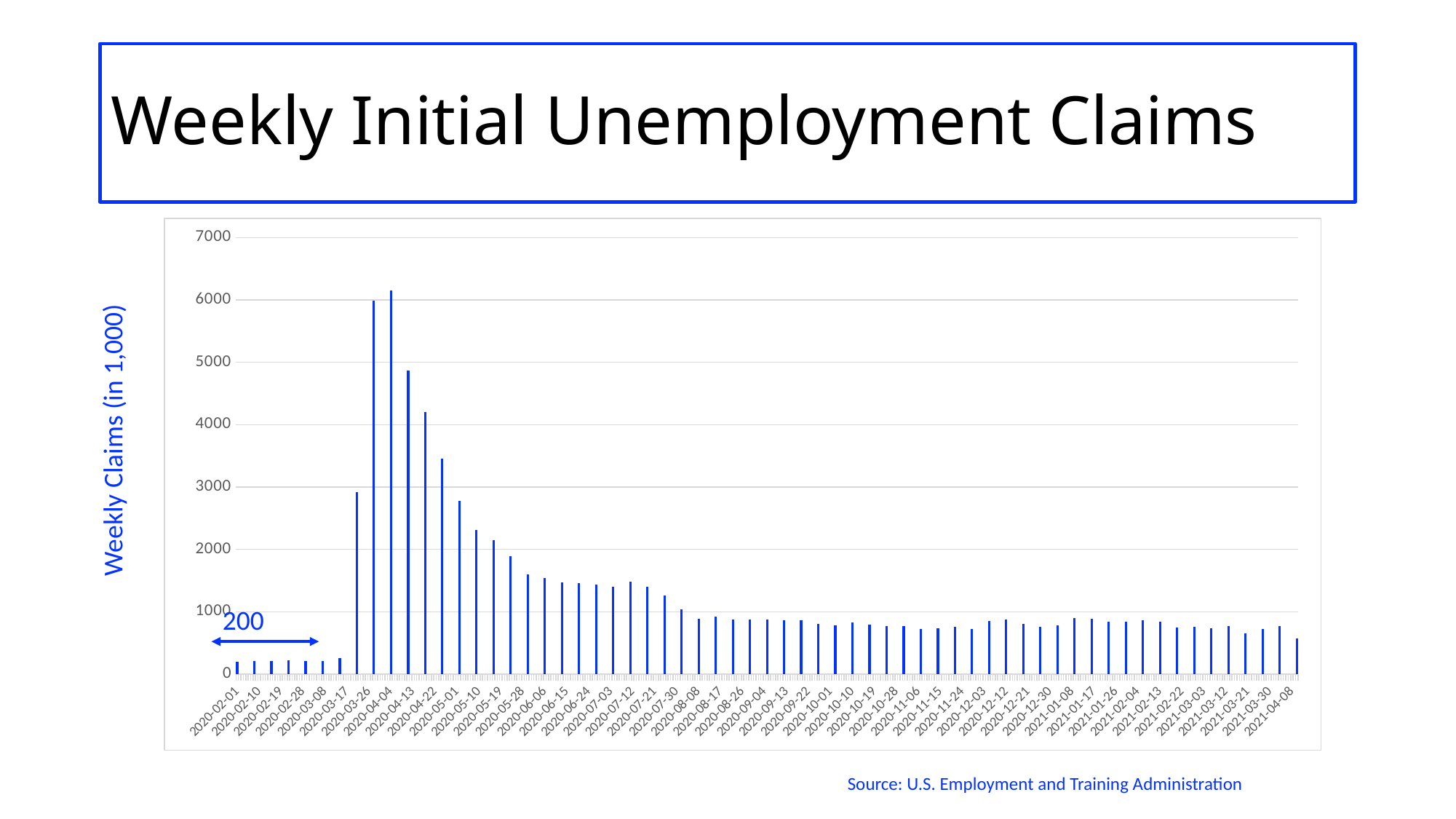
Do the values rise or fall along the x axis from 2020-04-04 to 2020-08-08? fall Is the value for 2020-04-13 greater or less than 4000? greater Is the value for 2021-04-08 greater or less than 1000? less What is the title of the slide's chart? Weekly Initial Unemployment Claims Is the value for 2020-02-01 greater or less than 1000? less What kind of chart is shown on the slide? bar chart Which is larger, the value for 2020-04-13 or the value for 2020-05-19? 2020-04-13 What is the label on the vertical axis of the chart? Weekly Claims (in 1,000)